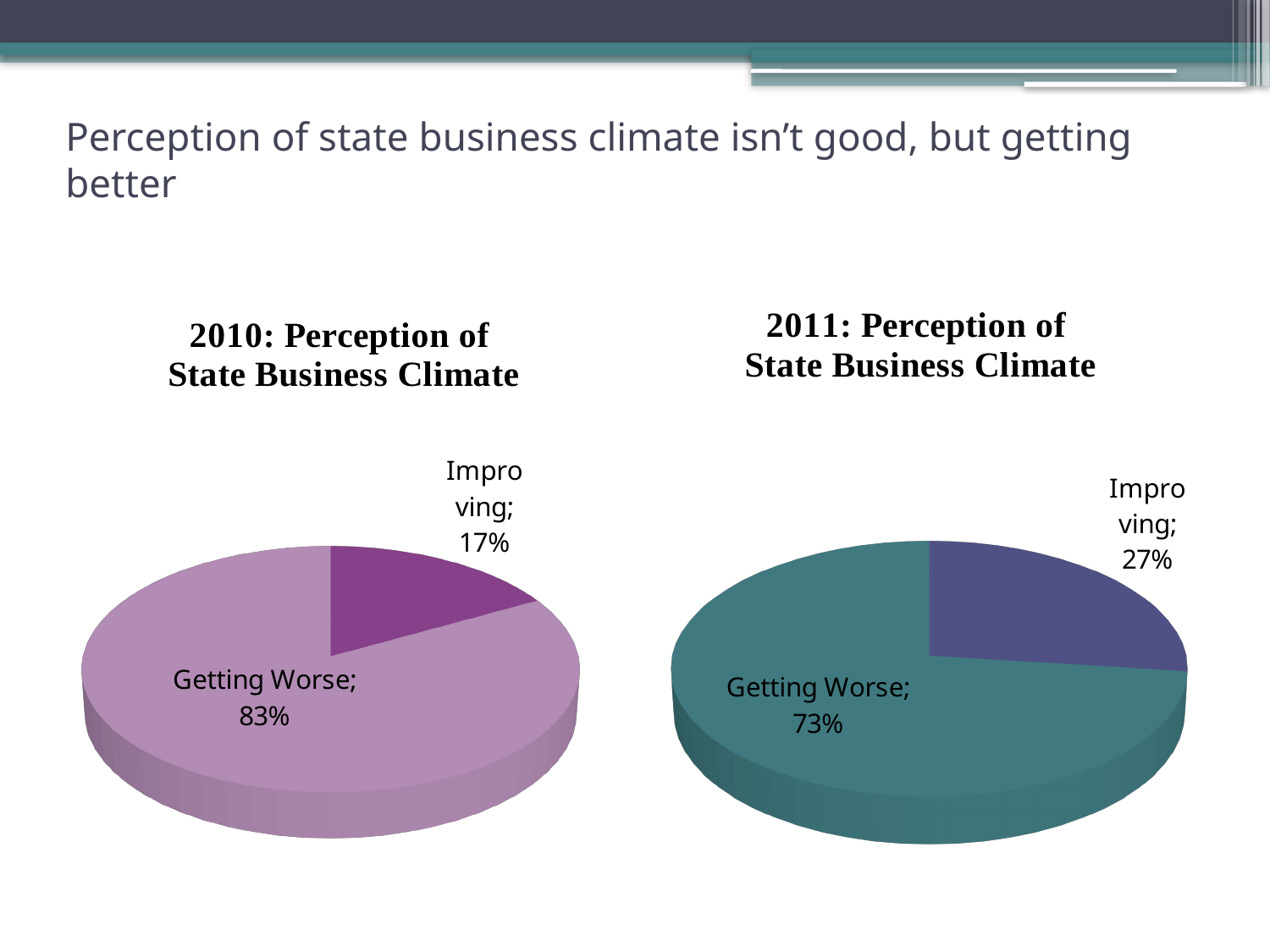
In the 2010: Perception of State Business Climate chart, which slice is the largest? Getting Worse How many slices does the 2010: Perception of State Business Climate chart have? 2 What is the title of the chart on the left side of the slide? 2010: Perception of State Business Climate By how many percentage points did the Improving share increase from the 2010 chart to the 2011 chart? 10 percentage points In the 2011: Perception of State Business Climate chart, what is the difference between the Getting Worse and Improving shares? 46% Is the Improving share larger in the 2010 chart or the 2011 chart? 2011 What kind of chart is the 2011: Perception of State Business Climate chart? Pie chart In the 2011: Perception of State Business Climate chart, what share of respondents said the climate is Getting Worse? 73% In the 2011: Perception of State Business Climate chart, what share of respondents said the climate is Improving? 27% In the 2010: Perception of State Business Climate chart, what share of respondents said the climate is Improving? 17% In the 2011: Perception of State Business Climate chart, which slice is the smallest? Improving In the 2010: Perception of State Business Climate chart, what share of respondents said the climate is Getting Worse? 83%